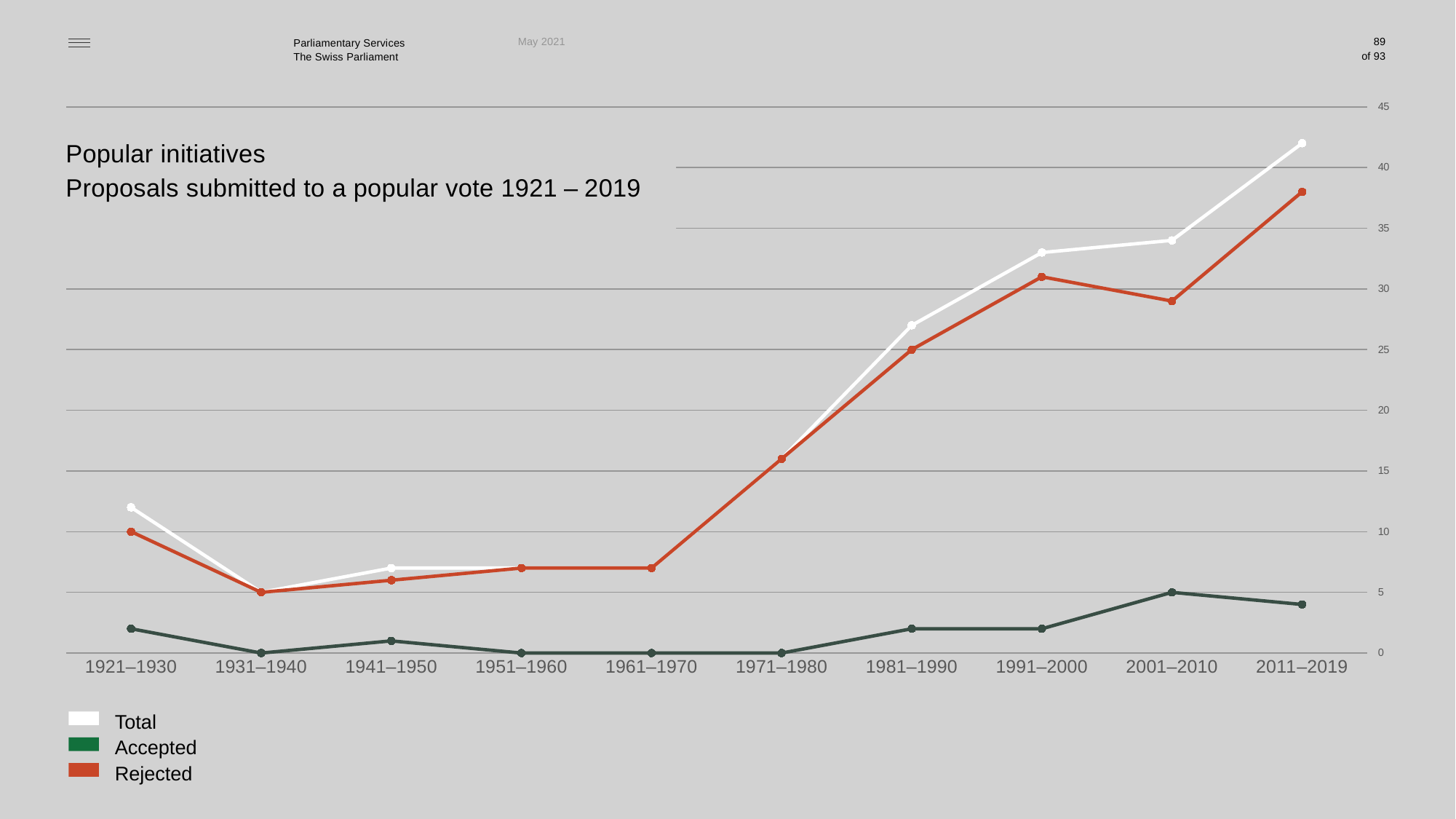
What is the Accepted value for 2001–2010? 5 Is the Rejected value for 2001–2010 greater or less than 30? less What kind of chart is shown on the slide? line chart How many decade periods are shown on the x axis? 10 What is the Rejected value for 1921–1930? 10 Which is larger, the Total value for 1991–2000 or the Total value for 1981–1990? 1991–2000 Which period has the highest Total value? 2011–2019 Which period has the lowest Rejected value? 1931–1940 Does the Total series rise or fall from 1961–1970 to 1991–2000? rise What is the Rejected value for 1981–1990? 25 Is the Total value for 2011–2019 greater or less than 40? greater How many series does the legend list? 3